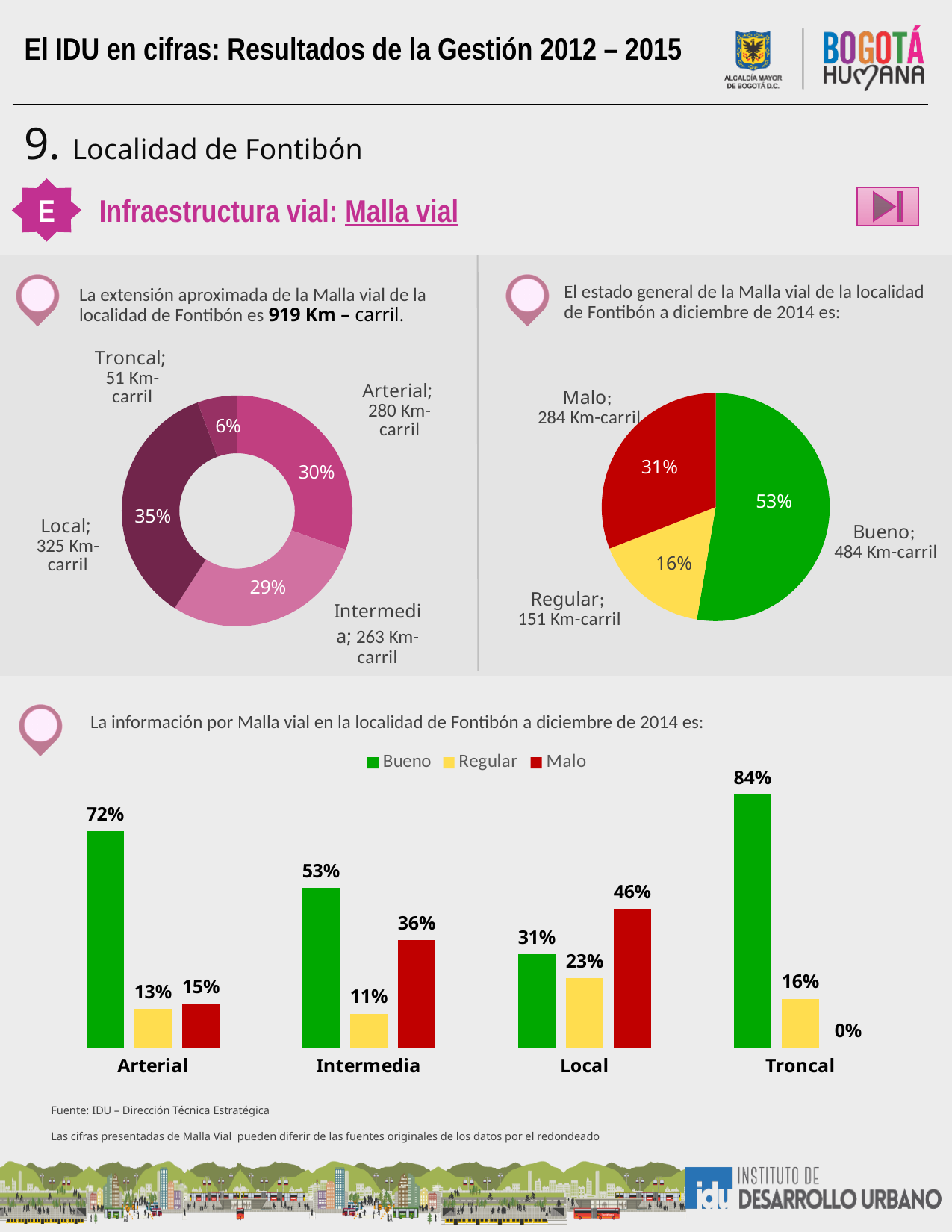
What type of chart is shown at the bottom of the slide? Bar chart In the bar chart at the bottom, how many series does the legend list? 3 In the pie chart on the right, which condition has the largest share? Bueno In the bar chart at the bottom, which category has the highest Bueno value? Troncal In the donut chart on the left, which category has the smallest share? Troncal In the bar chart at the bottom, what is the difference between the Bueno values for Arterial and Intermedia? 19% In the pie chart on the right, what share of the road network is in Bueno condition? 53% In the donut chart on the left, how many Km-carril does the Arterial category have? 280 Km-carril In the pie chart on the right, how many Km-carril are in Malo condition? 284 Km-carril In the donut chart on the left, what share of the road network is Local? 35% In the donut chart on the left, how many categories are shown? 4 In the bar chart at the bottom, what is the Malo value for Local? 46%